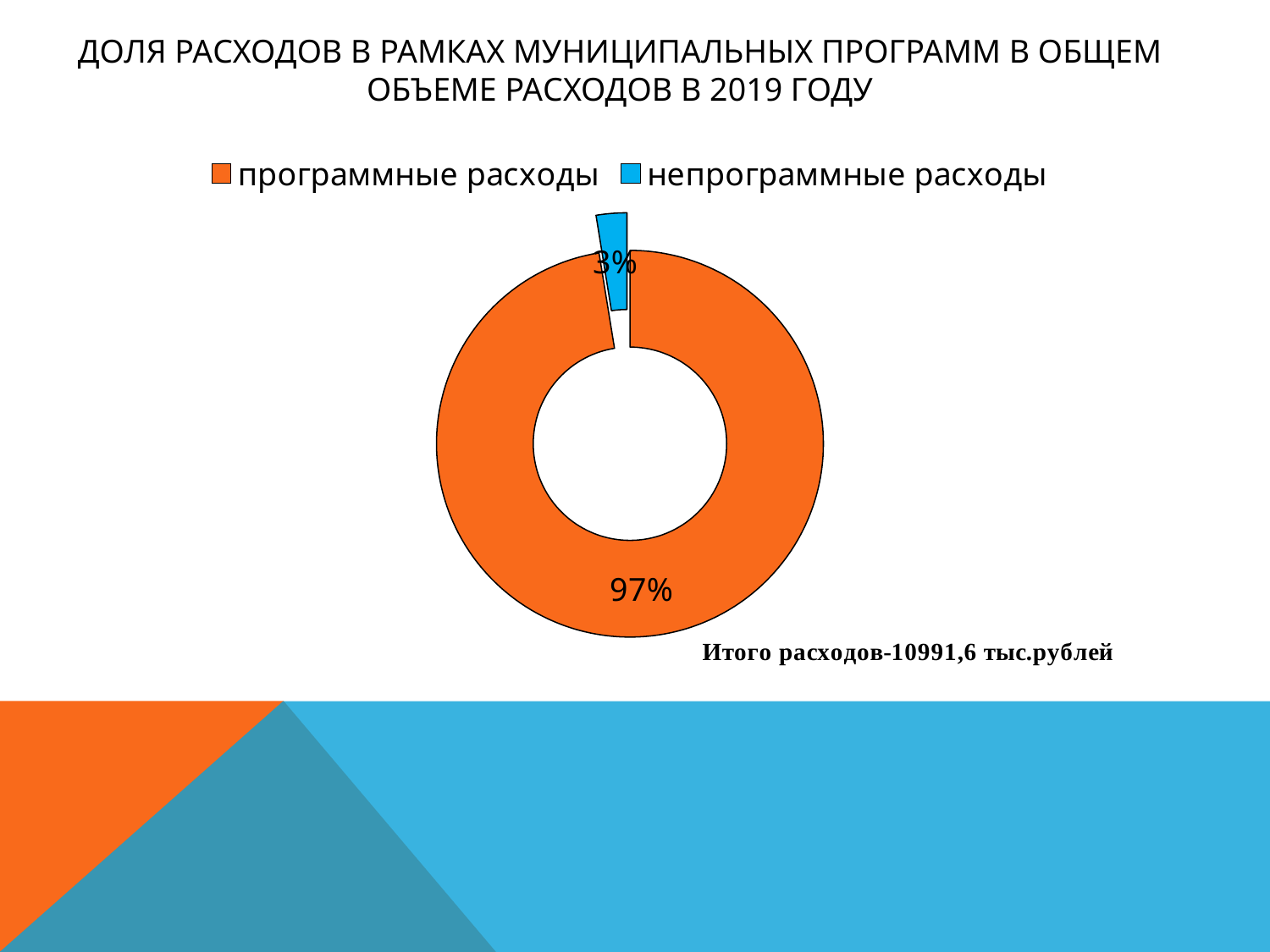
What is the difference in percentage points between the share for программные расходы and the share for непрограммные расходы? 94 What share of the chart is labelled for непрограммные расходы? 3% What share of the chart is labelled for программные расходы? 97% How many categories does the chart show? 2 What total expenditure amount is stated below the chart? 10991,6 тыс.рублей Which is larger: the share for программные расходы or the share for непрограммные расходы? программные расходы How many entries does the legend list? 2 What colour is the slice for непрограммные расходы? blue Which category has the smallest share of the chart? непрограммные расходы Which category has the largest share of the chart? программные расходы What kind of chart is shown on the slide? doughnut (pie) chart